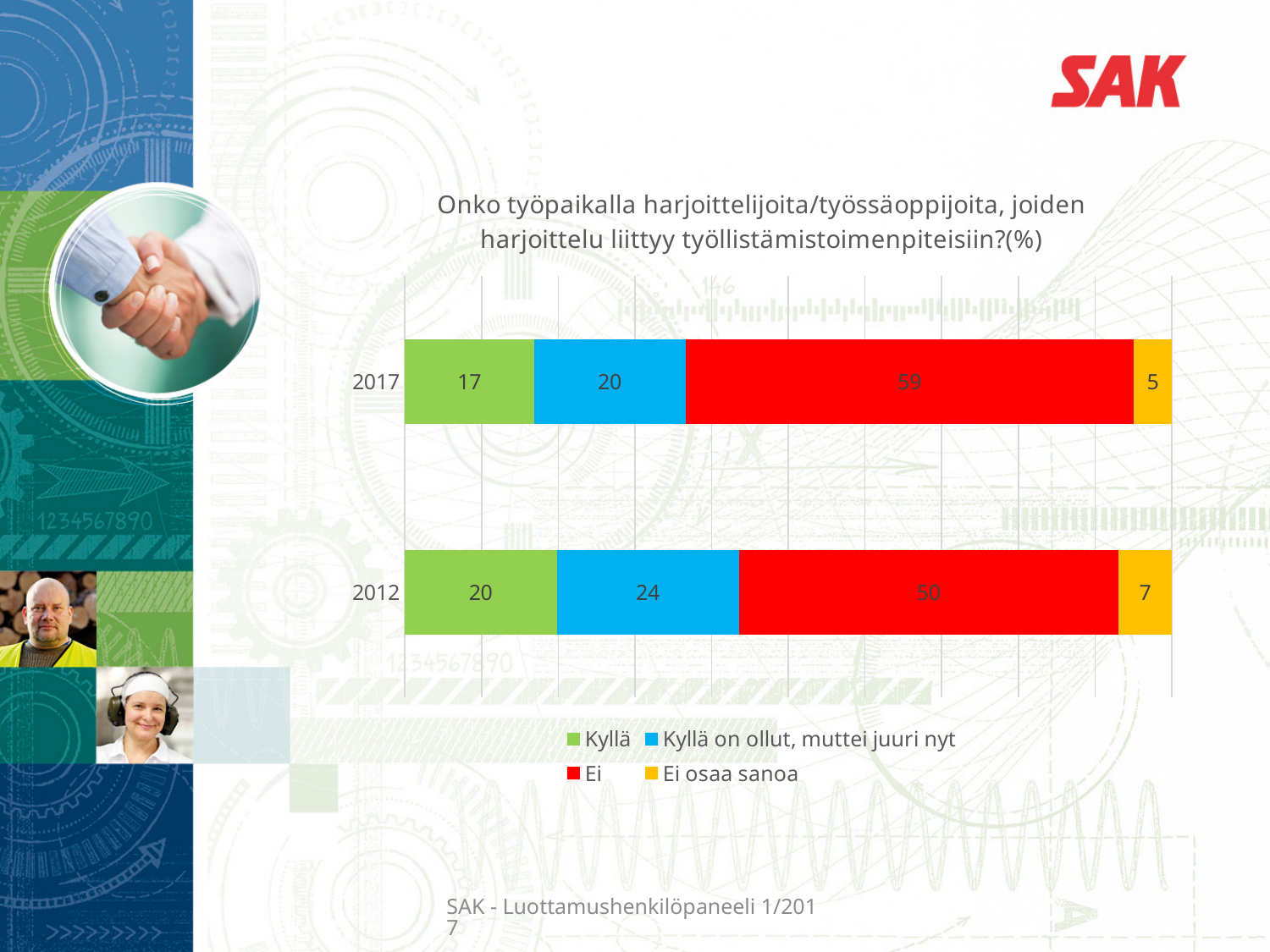
What is the value for "Kyllä" in 2017? 17 What is the total of the 2012 stacked bar? 101 How many years (categories) are shown in the chart? 2 How many series does the legend list? 4 Which series has the lowest value in the 2012 bar? Ei osaa sanoa What is the value for "Kyllä on ollut, muttei juuri nyt" in 2017? 20 What is the difference between the "Ei" values for 2017 and 2012? 9 Which series has the highest value in the 2017 bar? Ei Is the "Kyllä" value larger in 2012 or in 2017? 2012 What is the value for "Ei" in 2012? 50 What is the value for "Ei osaa sanoa" in 2012? 7 What kind of chart is shown on the slide? Stacked bar chart